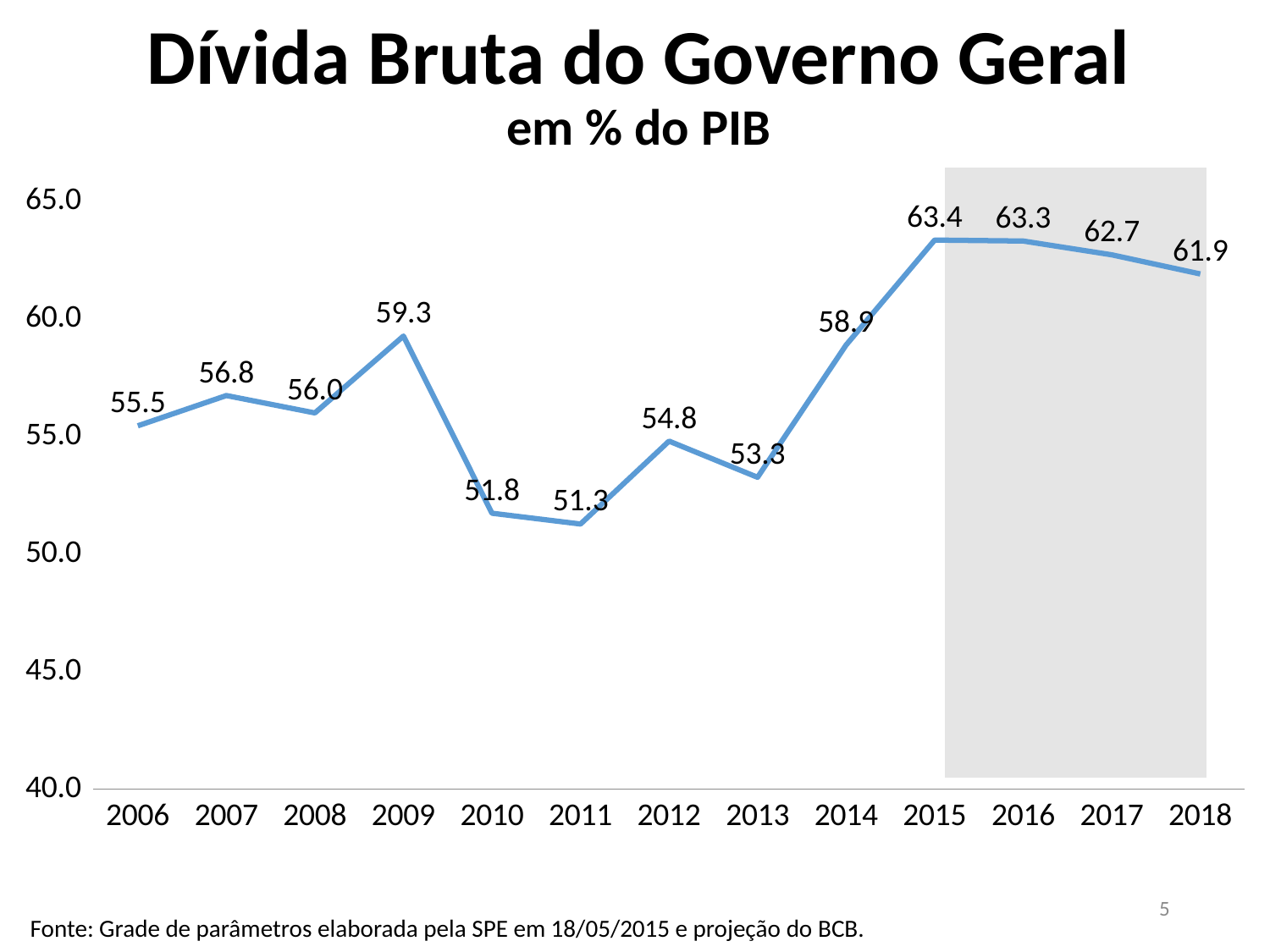
What is the value for 2018? 61.9 Is the value for 2010 greater or less than 55.0? less Which is larger, the value for 2012 or the value for 2008? 2008 What is the value for 2009? 59.3 How many years are shown on the x axis? 13 What kind of chart is this? line chart What is the difference between the values for 2014 and 2013? 5.6 What is the value for 2015? 63.4 Which year has the lowest value? 2011 What is the difference between the values for 2015 and 2011? 12.1 Do the values rise or fall from 2015 to 2018? fall Which year has the highest value? 2015